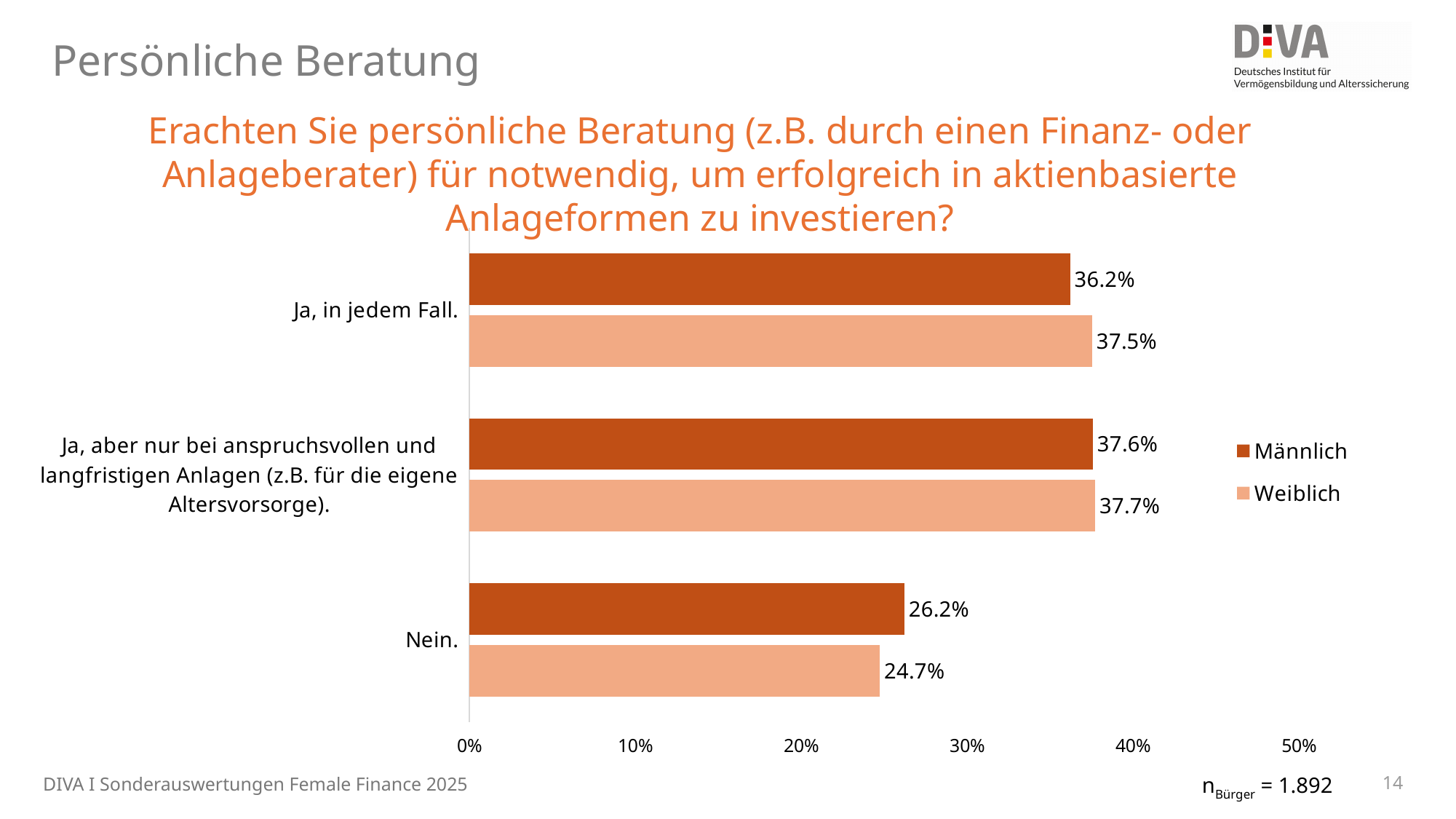
Which category has the lowest value for Weiblich? Nein. What is the value for Weiblich for "Ja, in jedem Fall."? 37.5% What is the value for Männlich for "Ja, in jedem Fall."? 36.2% For "Nein.", which is larger, the Männlich value or the Weiblich value? Männlich What is the value for Männlich for "Ja, aber nur bei anspruchsvollen und langfristigen Anlagen"? 37.6% What is the value for Weiblich for "Nein."? 24.7% Which category has the highest value for Männlich? Ja, aber nur bei anspruchsvollen und langfristigen Anlagen (z.B. für die eigene Altersvorsorge). Which series is shown in the darker orange colour in the legend? Männlich What is the difference between the Männlich and Weiblich values for "Nein."? 1.5% What kind of chart is shown on the slide? bar chart How many answer categories are shown on the chart? 3 How many series does the legend list? 2